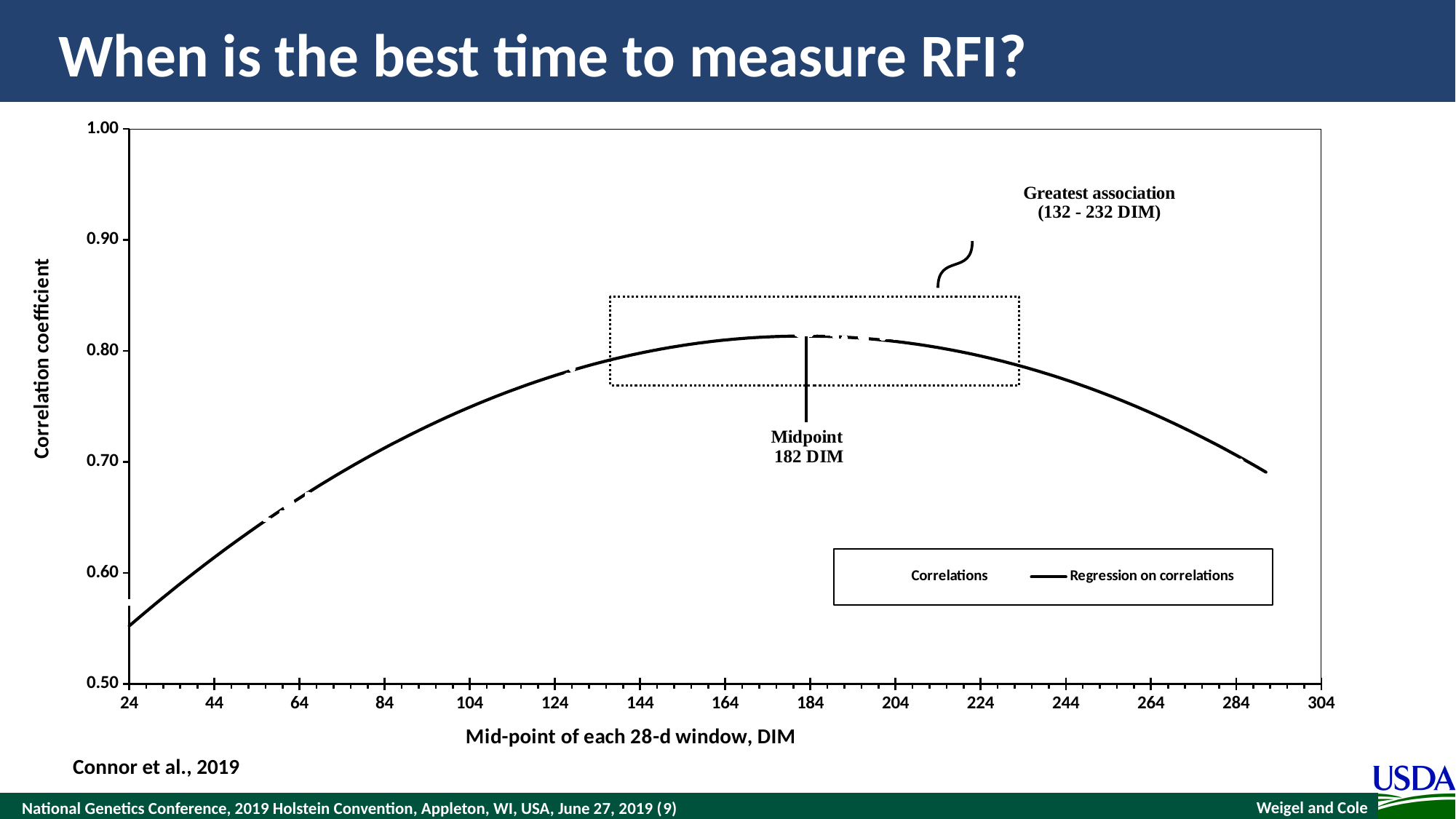
How many series does the legend list? 2 Is the correlation coefficient at 184 DIM greater or less than 0.80? greater Is the correlation coefficient at 24 DIM greater or less than 0.60? less What kind of chart is shown on the slide? line chart Is the correlation coefficient at 64 DIM greater or less than 0.70? less What are the two series named in the legend? Correlations; Regression on correlations Which is larger, the correlation coefficient at 24 DIM or at 184 DIM? 184 DIM What is the title of the y axis? Correlation coefficient Does the regression curve rise or fall between 184 DIM and 284 DIM? fall Does the regression curve rise or fall between 24 DIM and 184 DIM? rise